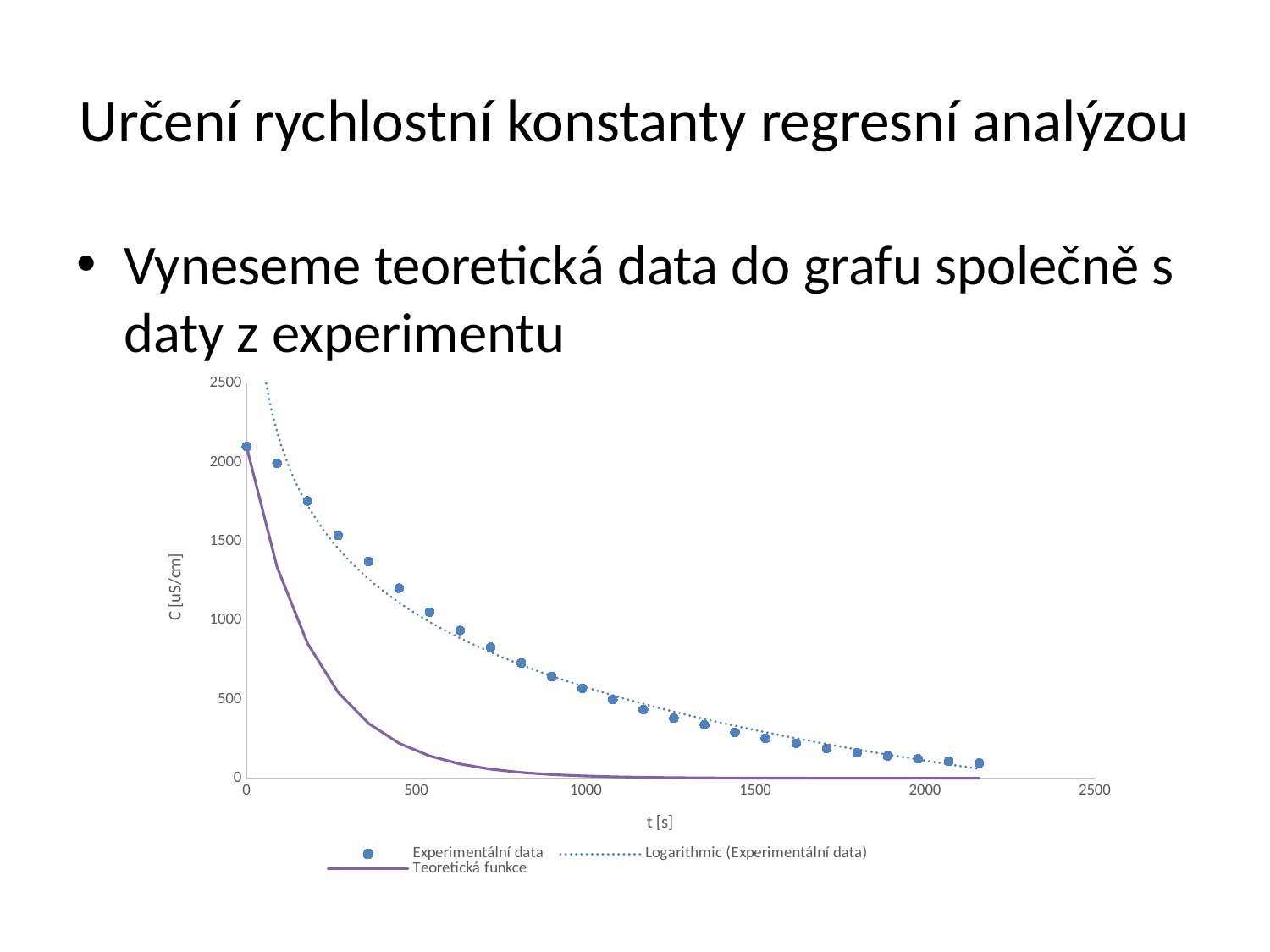
Is the value of the theoretical function at t = 1000 s greater or less than 500? less What is the label of the x axis? t [s] What is the label of the y axis? C [uS/cm] Is the value of the theoretical function at t = 500 s greater or less than 500? less How many series does the chart legend list? 3 Is the experimental data value at t = 2000 s greater or less than 500? less What kind of chart is shown on the slide? scatter chart Do the experimental data values rise or fall as t increases? fall At t = 500 s, which is larger: the experimental data value or the theoretical function value? experimental data Does the theoretical function (Teoretická funkce) rise or fall along the x axis? fall